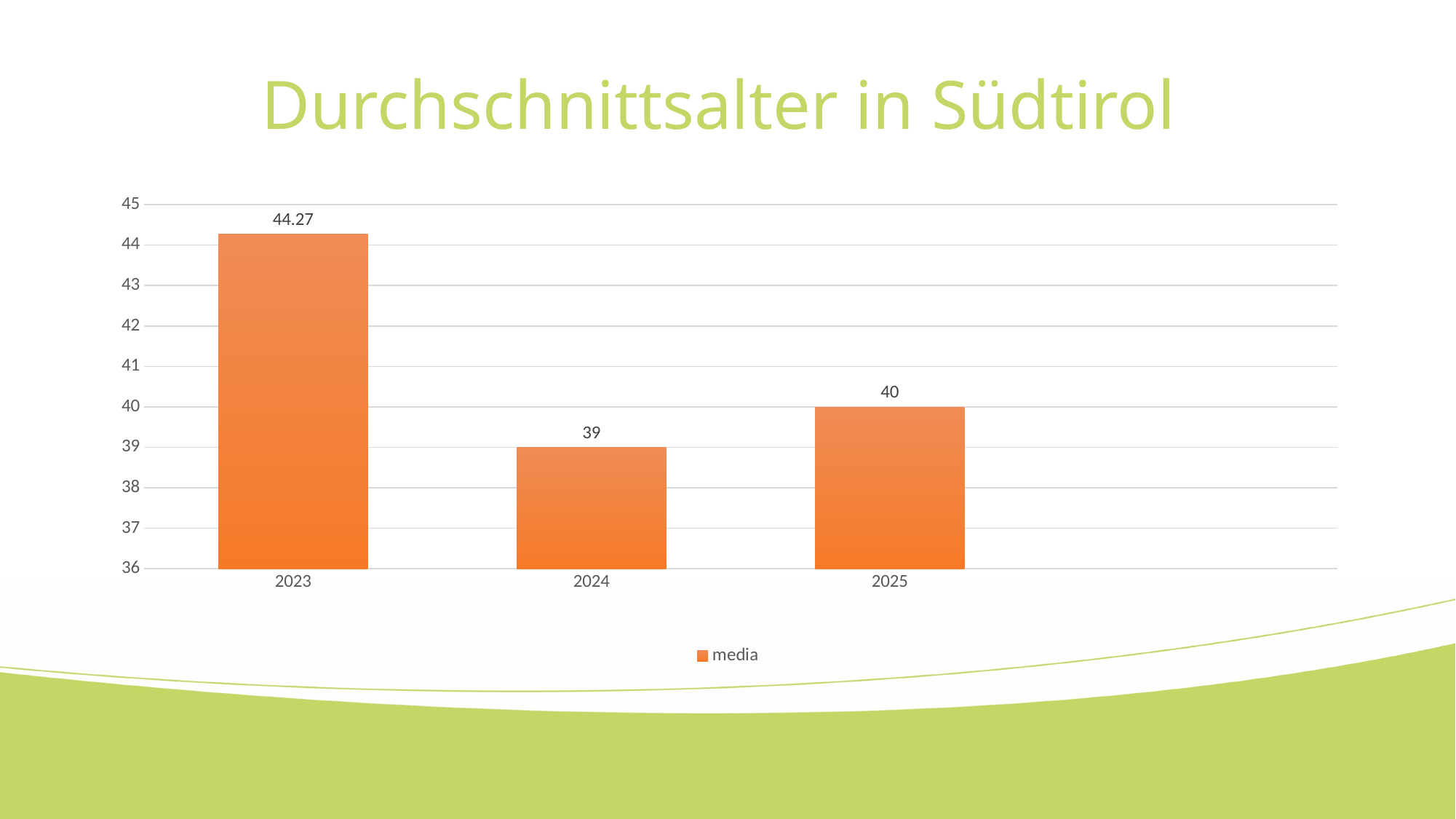
What is the difference between the values for 2023 and 2024? 5.27 What is the title of the chart? Durchschnittsalter in Südtirol Which is larger, the value for 2024 or the value for 2025? 2025 What is the value for 2023? 44.27 How many years are shown on the x axis? 3 Which year has the highest value? 2023 Is the value for 2023 greater or less than 44? greater Which year has the lowest value? 2024 What kind of chart is shown on the slide? bar chart What is the difference between the values for 2025 and 2024? 1 What is the value for 2025? 40 What is the value for 2024? 39